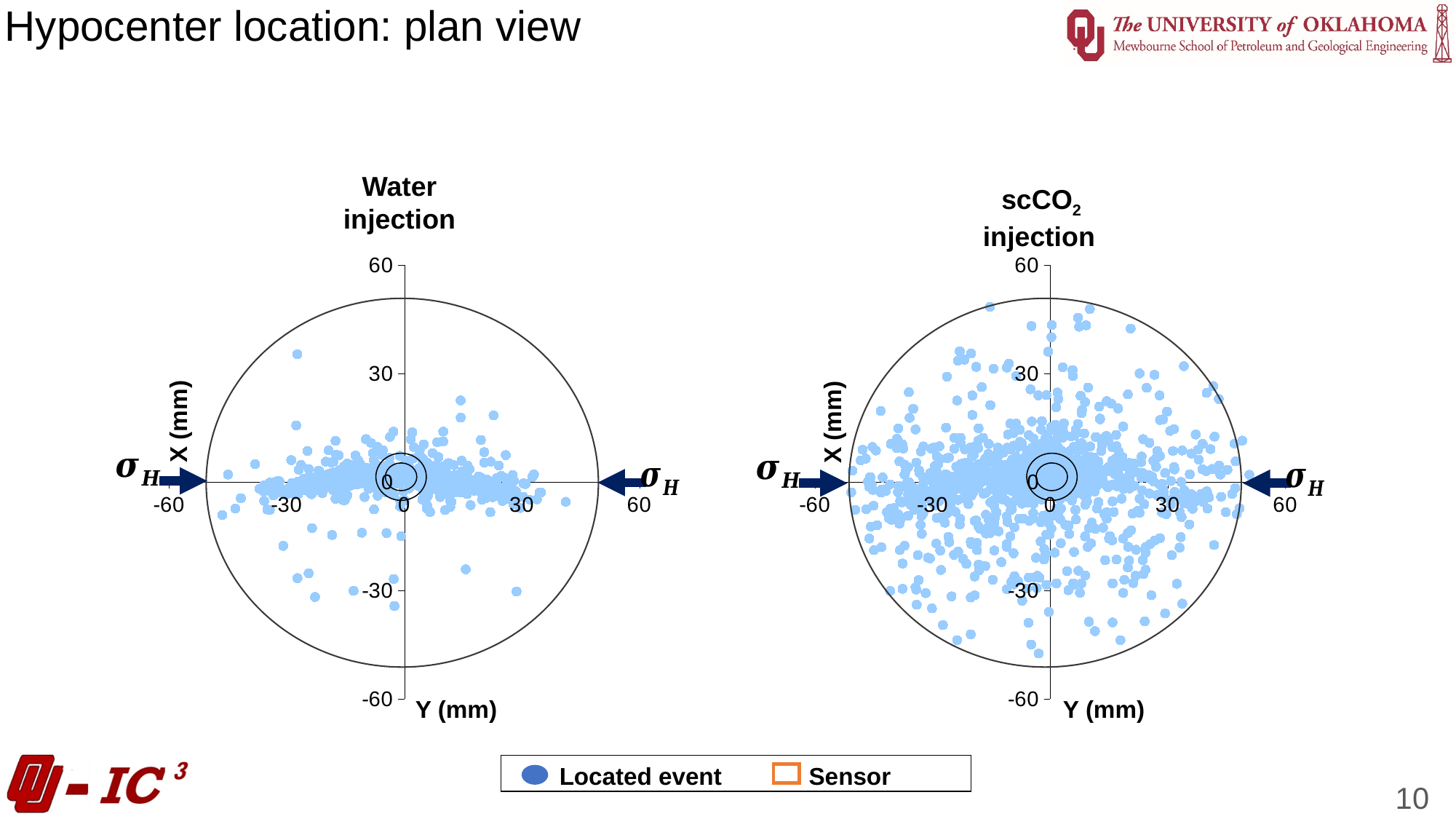
Which chart shows located events spread more widely along the X axis, Water injection or scCO2 injection? scCO2 injection What is the label of the vertical axis on the Water injection chart? X (mm) How many charts are shown on the slide? 2 What are the two entries in the legend? Located event, Sensor How many entries does the shared legend list? 2 Which chart contains more located event points, Water injection or scCO2 injection? scCO2 injection What kind of chart is the Water injection chart? scatter chart What kind of chart is the scCO2 injection chart? scatter chart